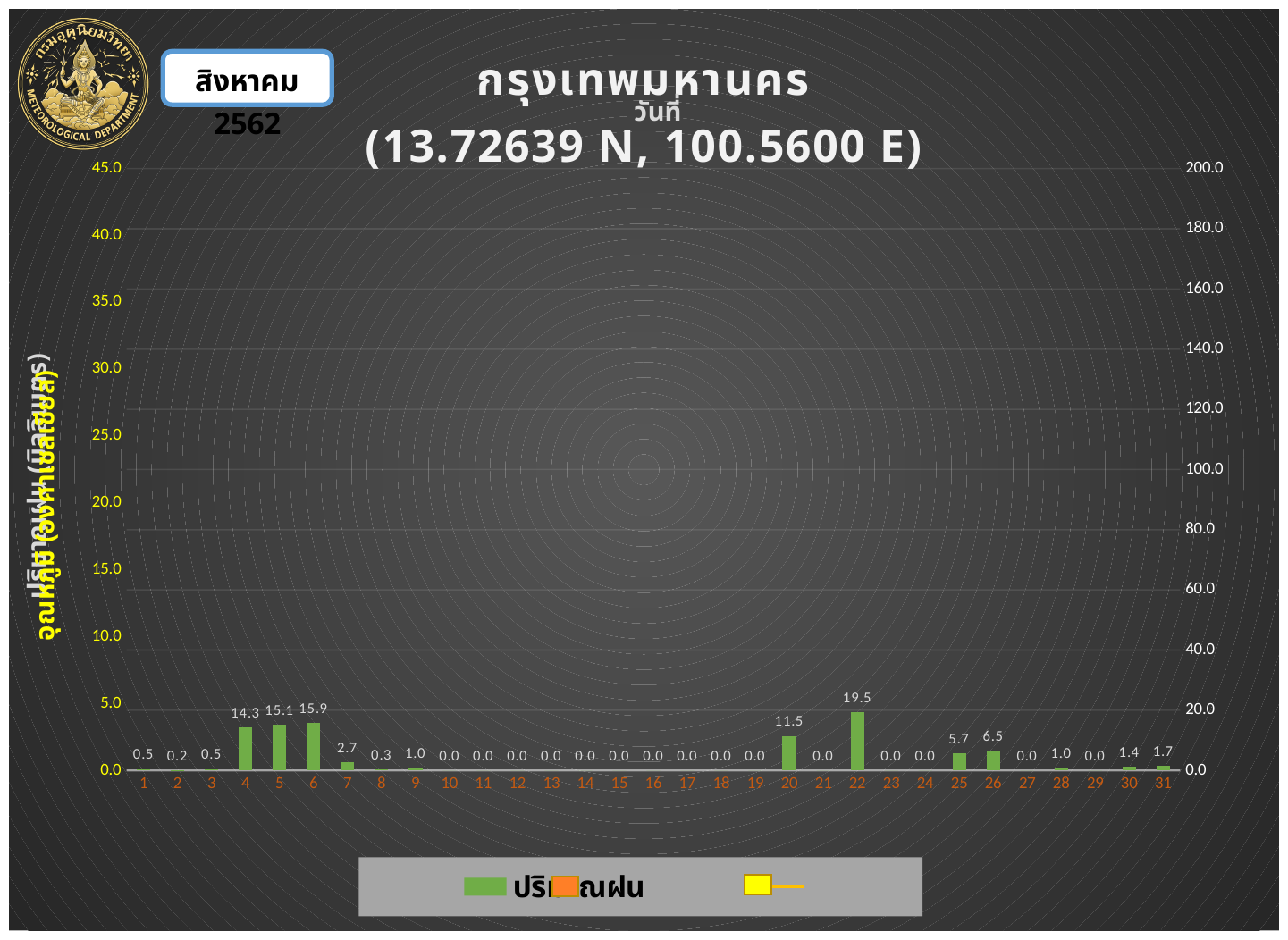
Which day has the highest rainfall value? 22 What is the rainfall value shown for day 26? 6.5 Which is larger, the rainfall value for day 25 or for day 26? day 26 How many days (categories) are shown on the x axis? 31 What is the difference between the rainfall values for day 22 and day 20? 8.0 What is the difference between the rainfall values for day 6 and day 5? 0.8 What is the total rainfall for days 4, 5 and 6 combined? 45.3 Which is larger, the rainfall value for day 4 or for day 20? day 4 What is the rainfall value shown for day 4? 14.3 What is the rainfall value shown for day 22? 19.5 What kind of chart is shown on the slide? bar chart What coordinates are given in the chart title? 13.72639 N, 100.5600 E